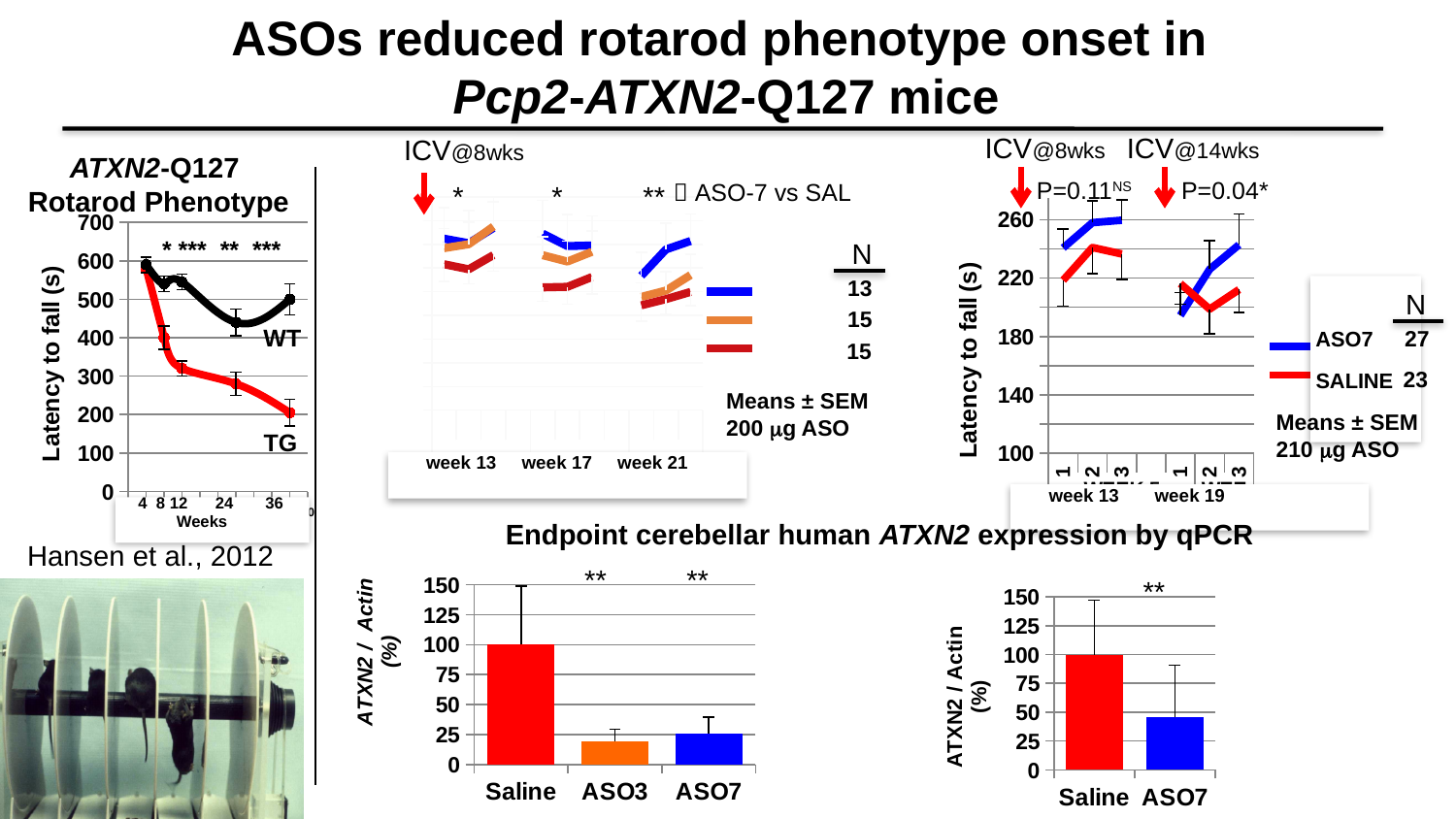
In the bottom-middle bar chart (Saline, ASO3, ASO7), is the value for Saline greater or less than 75? greater In the bottom-middle chart with Saline, ASO3 and ASO7, what kind of chart is it? bar chart In the top-left 'ATXN2-Q127 Rotarod Phenotype' chart, how many series are plotted? 2 In the top-left 'ATXN2-Q127 Rotarod Phenotype' chart, which group has the higher latency to fall at week 36, WT or TG? WT In the bottom-middle bar chart (Saline, ASO3, ASO7), how many categories are shown on the x axis? 3 In the top-left 'ATXN2-Q127 Rotarod Phenotype' chart, does the TG line rise or fall as weeks increase? fall In the bottom-middle bar chart (Saline, ASO3, ASO7), which category has the highest ATXN2/Actin value? Saline In the bottom-middle bar chart (Saline, ASO3, ASO7), is the value for ASO3 greater or less than 50? less In the bottom-right bar chart (Saline, ASO7), how many categories are shown? 2 In the top-right line chart comparing ASO7 and SALINE, what N is listed for ASO7 in the legend? 27 In the bottom-right bar chart (Saline, ASO7), is the value for ASO7 greater or less than 75? less In the bottom-right bar chart (Saline, ASO7), which bar is taller, Saline or ASO7? Saline